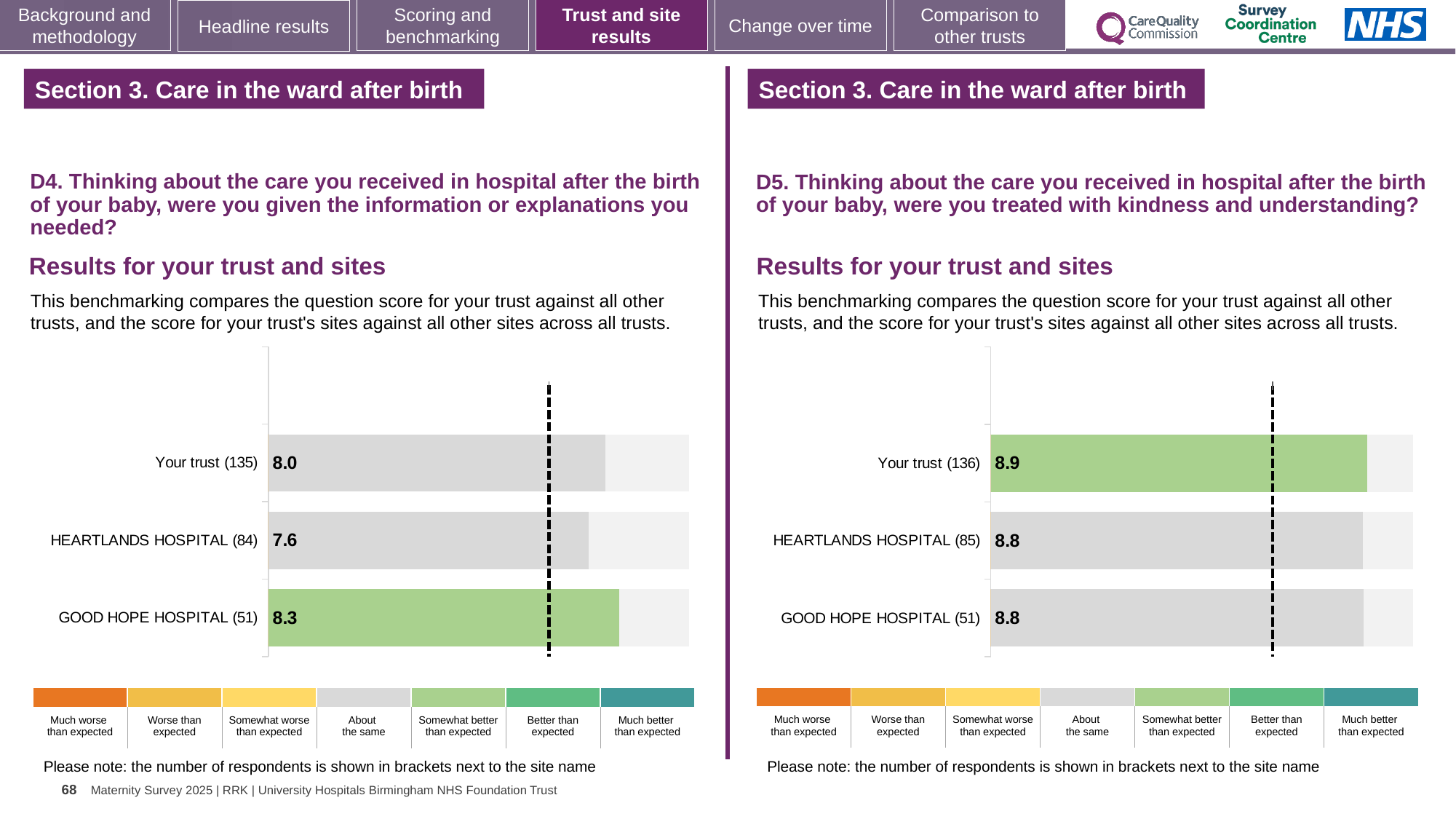
In the D4 chart on the left, which site or trust has the highest score? GOOD HOPE HOSPITAL (51) In the D4 chart on the left, what is the score for HEARTLANDS HOSPITAL (84)? 7.6 Which is larger: the score for Your trust in the D4 chart on the left or the score for Your trust in the D5 chart on the right? D5 (8.9) In the D5 chart on the right, what is the score for Your trust (136)? 8.9 In the D4 chart on the left, what is the score for Your trust (135)? 8.0 How many bars are shown in the D4 chart on the left? 3 In the D5 chart on the right, what is the score for GOOD HOPE HOSPITAL (51)? 8.8 In the D5 chart on the right, which bar has the highest score? Your trust (136) What type of chart is used in the D5 chart on the right? Bar chart In the D5 chart on the right, what is the difference between the scores for Your trust (136) and HEARTLANDS HOSPITAL (85)? 0.1 In the D4 chart on the left, which site or trust has the lowest score? HEARTLANDS HOSPITAL (84) In the D4 chart on the left, what is the difference between the scores for GOOD HOPE HOSPITAL (51) and HEARTLANDS HOSPITAL (84)? 0.7